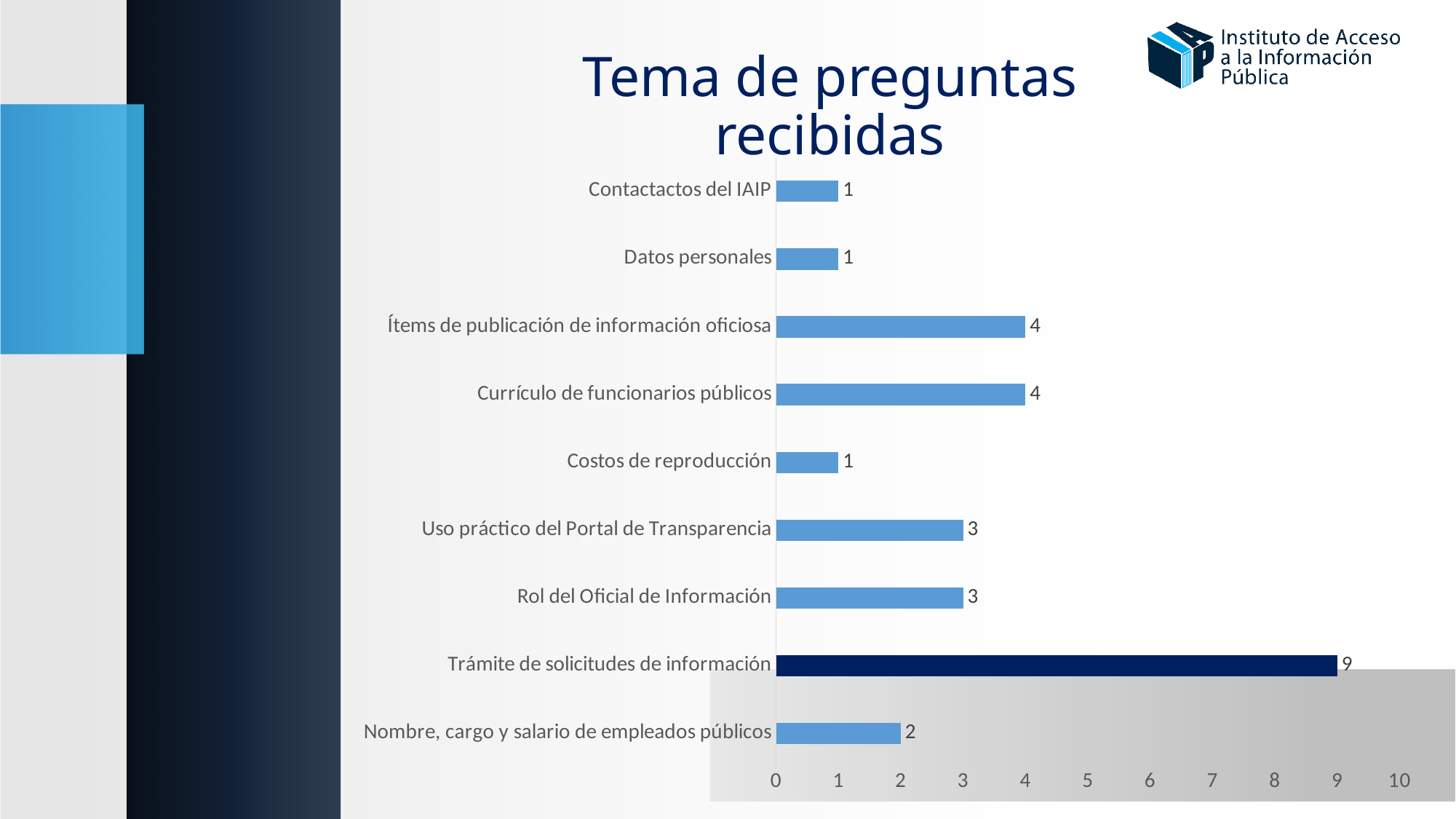
Which bar is shown in a darker colour than the others? Trámite de solicitudes de información What is the value for Currículo de funcionarios públicos? 4 What is the title of the chart? Tema de preguntas recibidas What is the value for Nombre, cargo y salario de empleados públicos? 2 What is the value for Uso práctico del Portal de Transparencia? 3 What is the difference between Trámite de solicitudes de información and Ítems de publicación de información oficiosa? 5 Which category has the highest value? Trámite de solicitudes de información Which is larger, Rol del Oficial de Información or Datos personales? Rol del Oficial de Información How many categories have a value of 1? 3 What is the value for Trámite de solicitudes de información? 9 How many categories are shown in the chart? 9 What kind of chart is shown on the slide? Bar chart